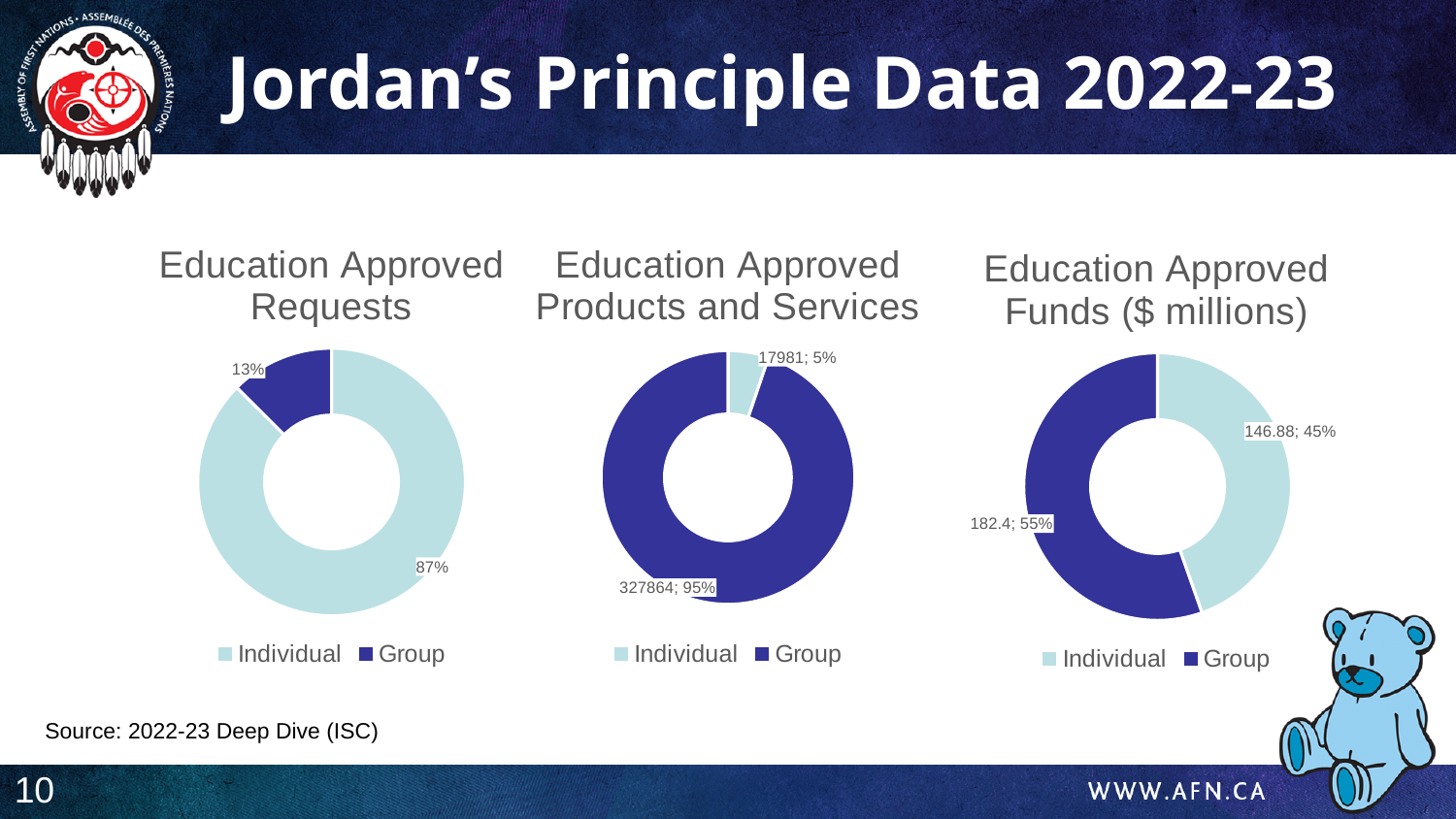
In the Education Approved Requests chart, what share of requests is Individual? 87% In the Education Approved Funds ($ millions) chart, what is the value for Group? 182.4 In the Education Approved Funds ($ millions) chart, what percentage share does Group have? 55% In the Education Approved Funds ($ millions) chart, what is the value for Individual? 146.88 In the Education Approved Products and Services chart, what percentage share does Individual have? 5% In the Education Approved Requests chart, which category has the largest share? Individual In the Education Approved Funds ($ millions) chart, which category is larger, Individual or Group? Group In the Education Approved Products and Services chart, what is the value for Group? 327864 In the Education Approved Requests chart, what share of requests is Group? 13% In the Education Approved Funds ($ millions) chart, what is the difference between the Group and Individual values? 35.52 What kind of chart is the Education Approved Requests chart? doughnut chart In the Education Approved Products and Services chart, what is the value for Individual? 17981